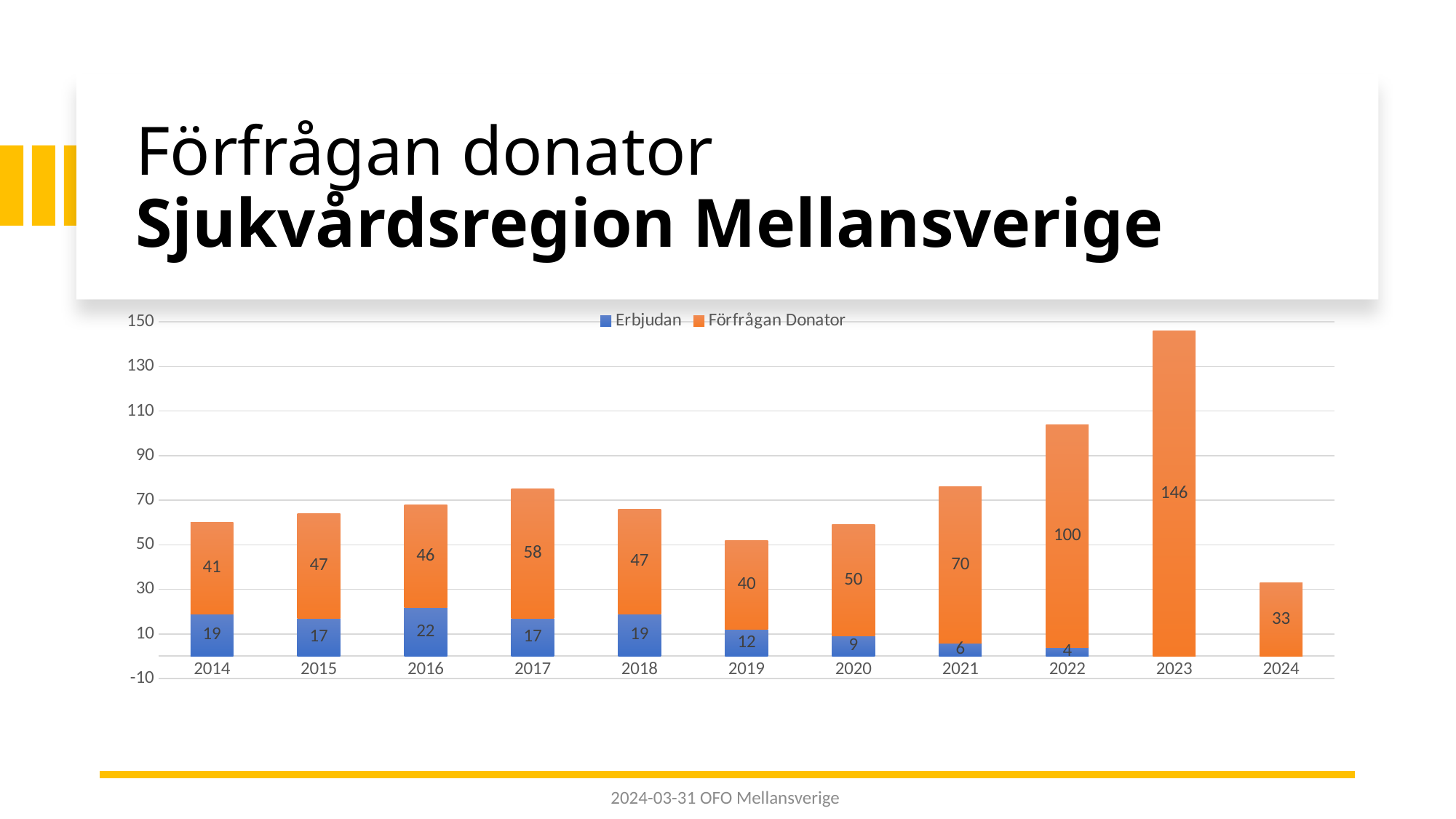
Which is larger, the Erbjudan value for 2014 or for 2019? 2014 How many series does the legend list? 2 What is the Erbjudan value for 2016? 22 Which year has the highest Förfrågan Donator value? 2023 How many years are shown on the x axis? 11 What is the Förfrågan Donator value for 2023? 146 What is the total of the stacked bar for 2017? 75 Which series is shown in orange in the legend? Förfrågan Donator Which year has the lowest Förfrågan Donator value? 2024 What type of chart is shown on the slide? stacked bar chart What is the difference between the Förfrågan Donator values for 2023 and 2022? 46 What is the Förfrågan Donator value for 2024? 33